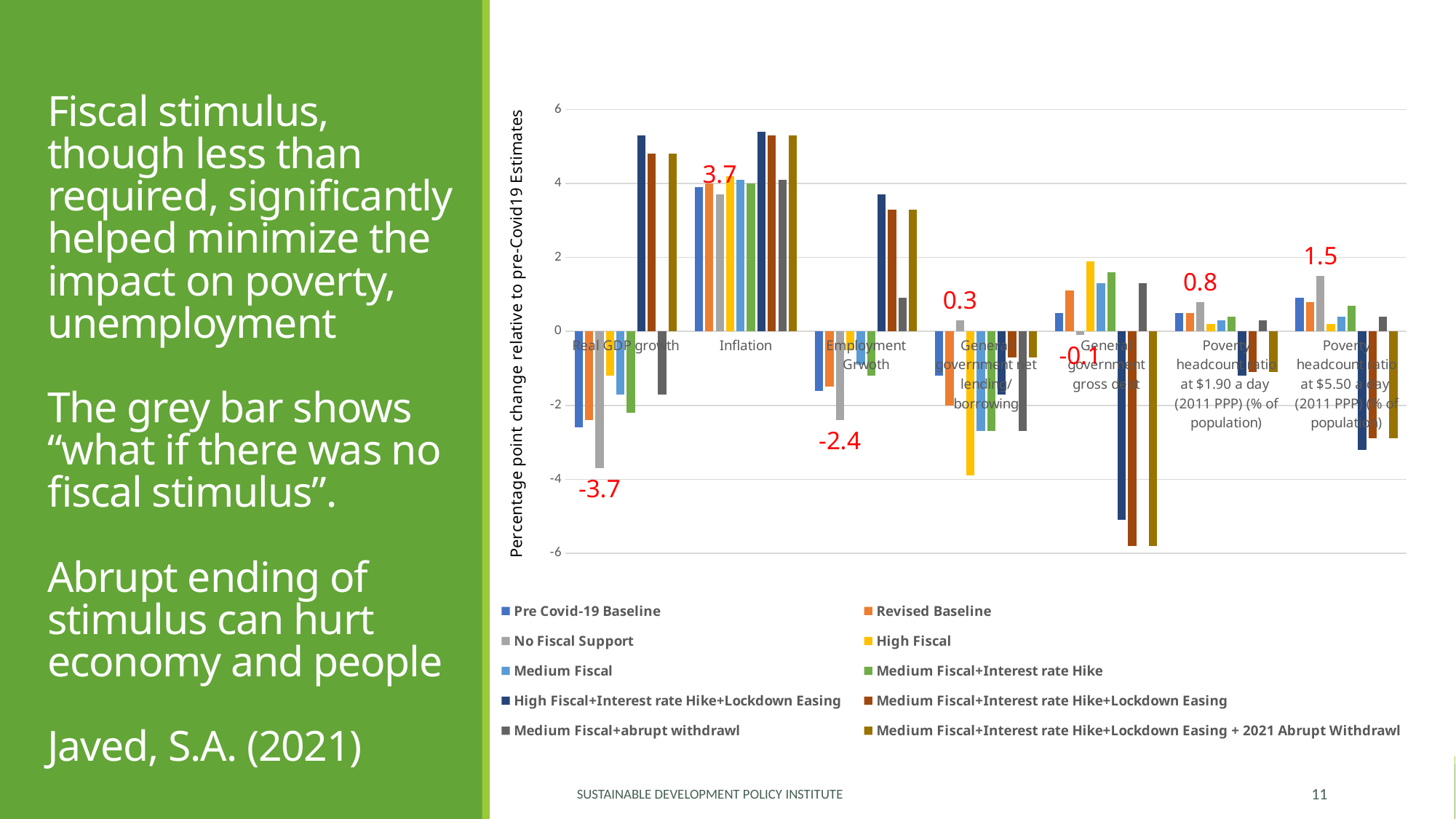
What is the label on the vertical axis of the chart? Percentage point change relative to pre-Covid19 Estimates How many categories are shown along the x axis? 7 How many series does the legend list? 10 What kind of chart is shown on the slide? bar chart What is the labelled value of the No Fiscal Support bar for Real GDP growth? -3.7 What is the labelled value of the No Fiscal Support bar for Employment Growth? -2.4 Is the Pre Covid-19 Baseline value for Inflation greater or less than 2? greater Is the High Fiscal value for General government net lending/borrowing greater or less than -2? less What is the labelled value of the No Fiscal Support bar for Poverty headcount ratio at $5.50 a day? 1.5 What is the difference between the labelled No Fiscal Support values for Inflation and Real GDP growth? 7.4 What is the labelled value of the No Fiscal Support bar for Inflation? 3.7 Which is larger for the No Fiscal Support series: the value for Inflation or the value for Employment Growth? Inflation